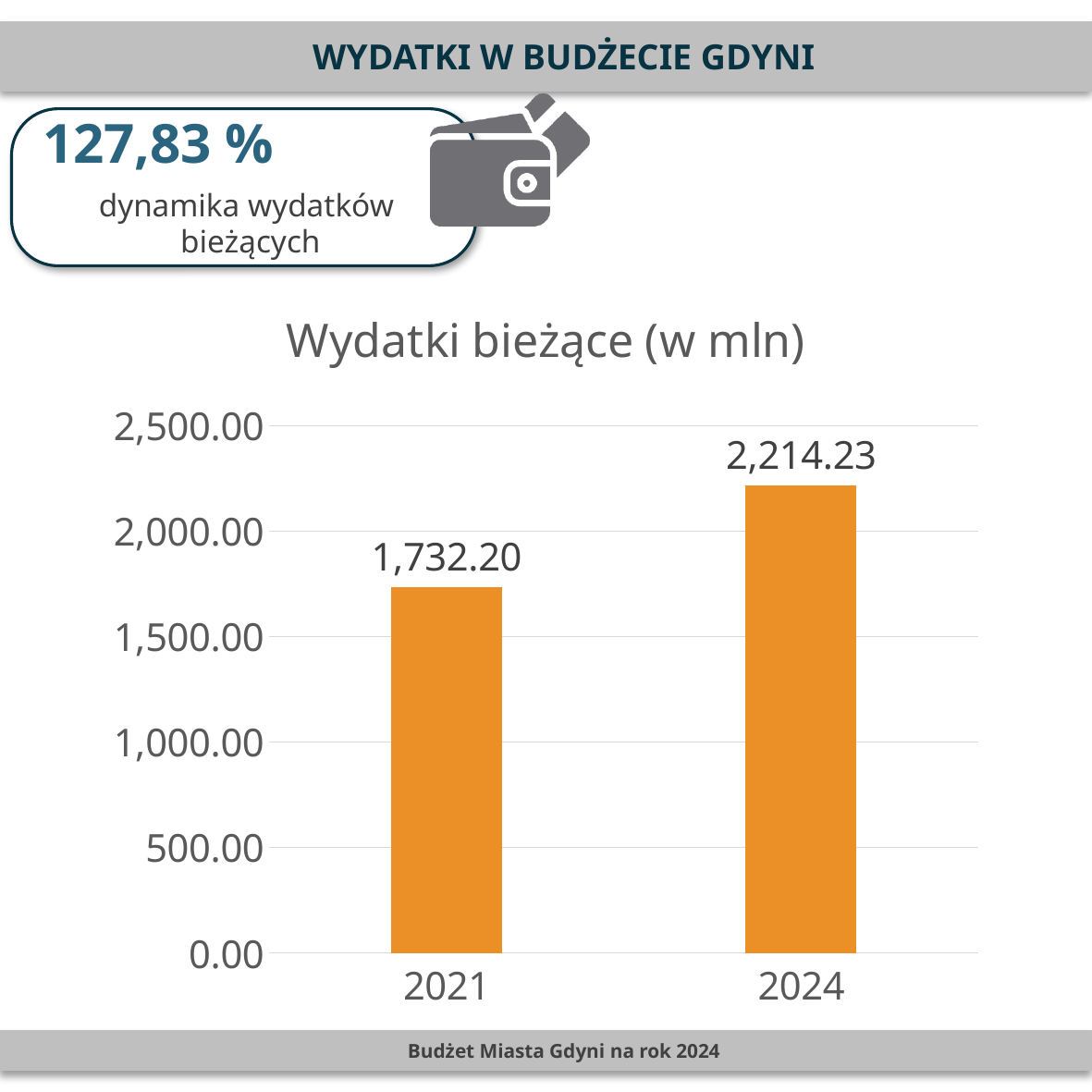
What kind of chart is shown on the slide? bar chart What is the difference between the 2024 and 2021 values? 482.03 What is the value for 2021 in the chart? 1,732.20 How many bars are shown in the chart? 2 Which year has the higher value? 2024 Is the value for 2024 greater or less than 2,000.00? greater What is the value for 2024 in the chart? 2,214.23 What is the title of the chart? Wydatki bieżące (w mln) Which year has the lower value? 2021 Is the value for 2021 greater or less than 2,000.00? less What colour are the bars in the chart? orange Do the values rise or fall from 2021 to 2024? rise